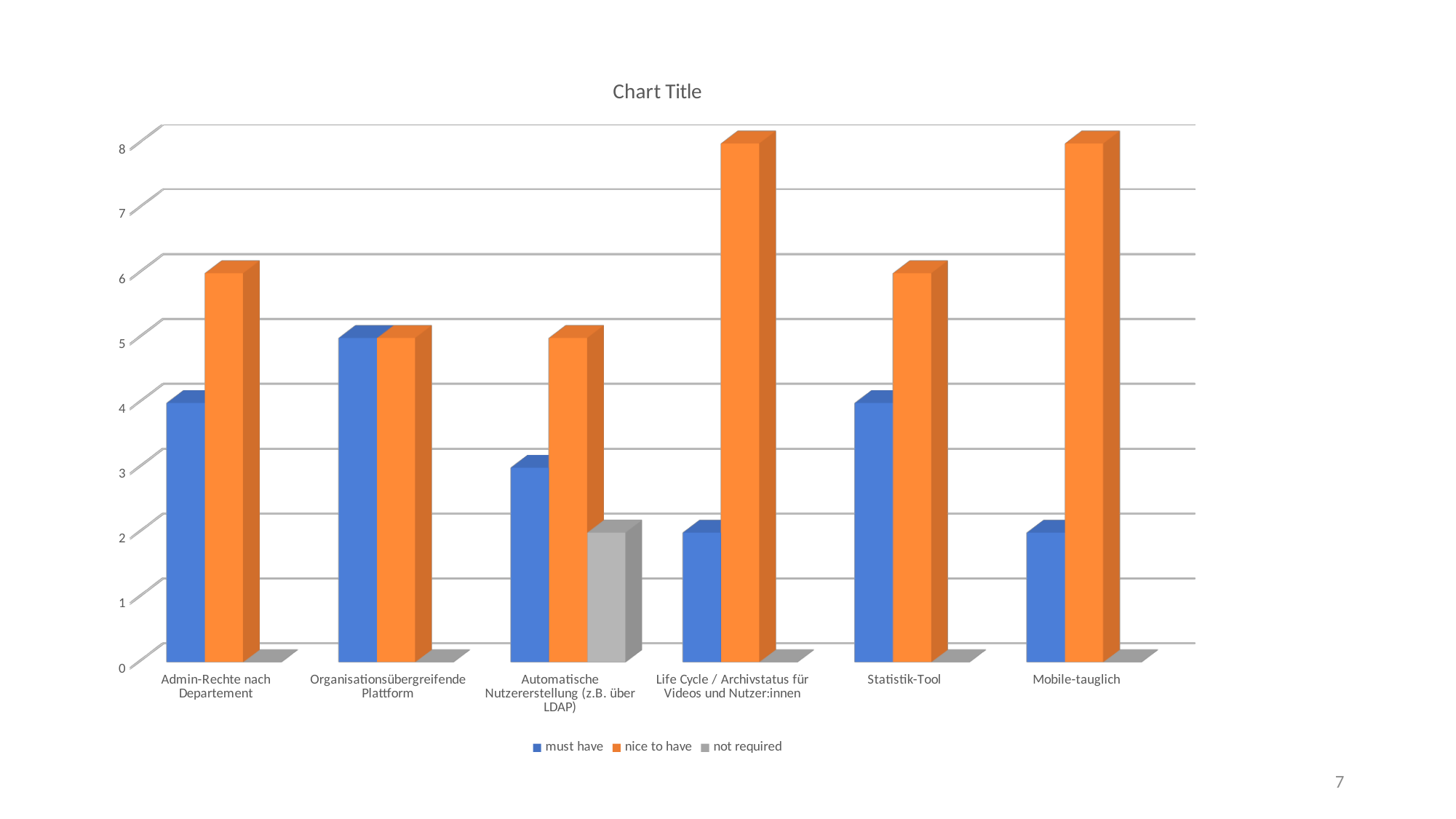
Which category has the highest 'must have' value? Organisationsübergreifende Plattform Is the 'nice to have' value for Life Cycle / Archivstatus für Videos und Nutzer:innen greater or less than 7? greater Is the 'must have' value for Mobile-tauglich greater or less than 3? less Which category has the lowest 'nice to have' value? Organisationsübergreifende Plattform and Automatische Nutzererstellung (z.B. über LDAP) (tied at 5) What is the title of the chart? Chart Title How many categories are shown on the x axis? 6 Which category has the only visible 'not required' bar? Automatische Nutzererstellung (z.B. über LDAP) What kind of chart is shown on the slide? bar chart Is the 'nice to have' value for Admin-Rechte nach Departement greater or less than 5? greater How many series does the legend list? 3 Which series is shown in orange? nice to have Which is larger for Statistik-Tool, the 'must have' value or the 'nice to have' value? nice to have